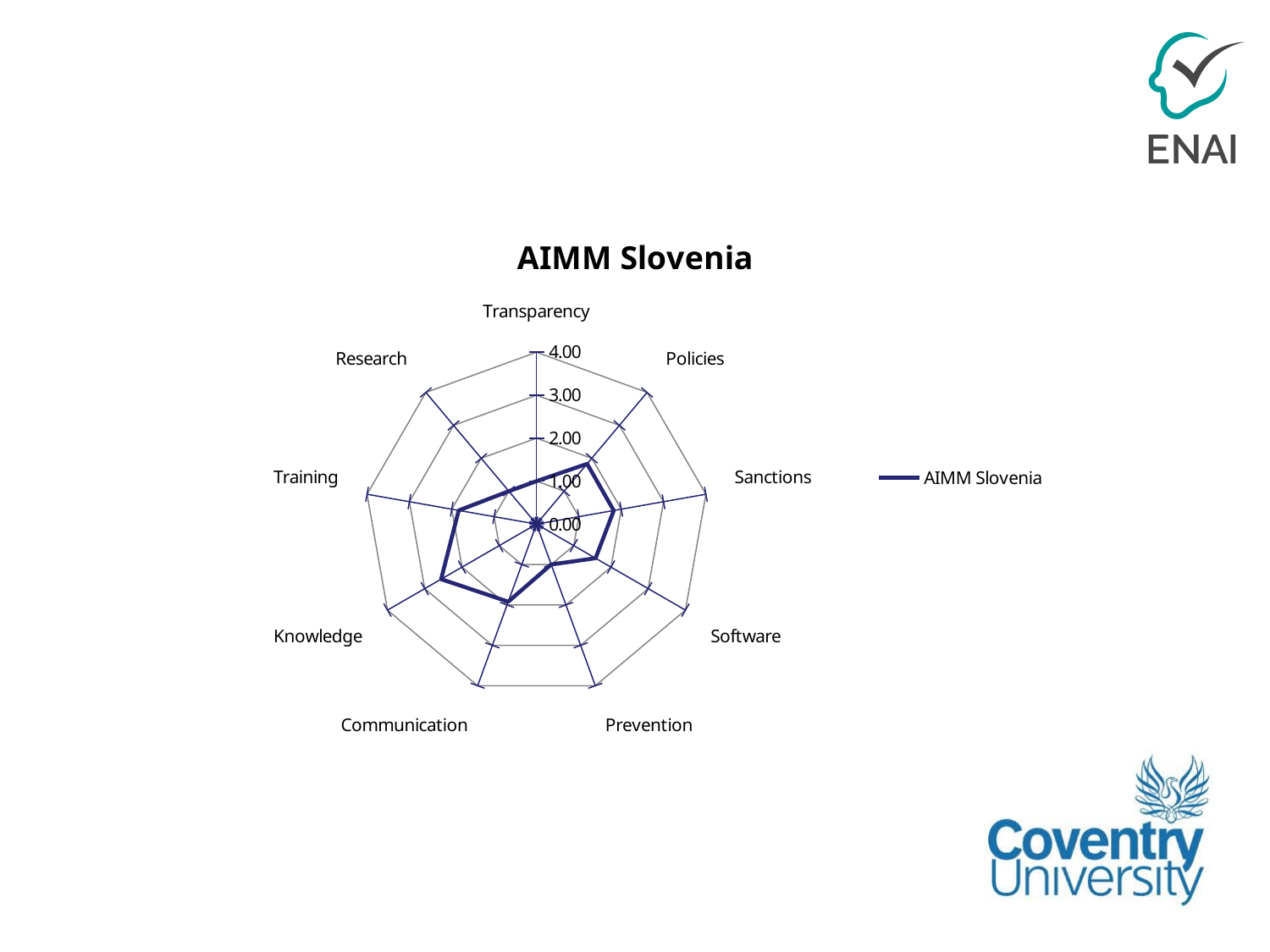
What is the name of the series shown in the legend? AIMM Slovenia Is the value for Prevention greater or less than 2.00? less Which category has the highest value? Knowledge What is the title of the chart? AIMM Slovenia Is the value for Policies greater or less than 3.00? less What is the maximum value shown on the radial axis? 4.00 Is the value for Transparency greater or less than 2.00? less How many categories (axes) does the radar chart have? 9 What kind of chart is shown on the slide? Radar chart Which has the larger value, Knowledge or Transparency? Knowledge How many series does the legend list? 1